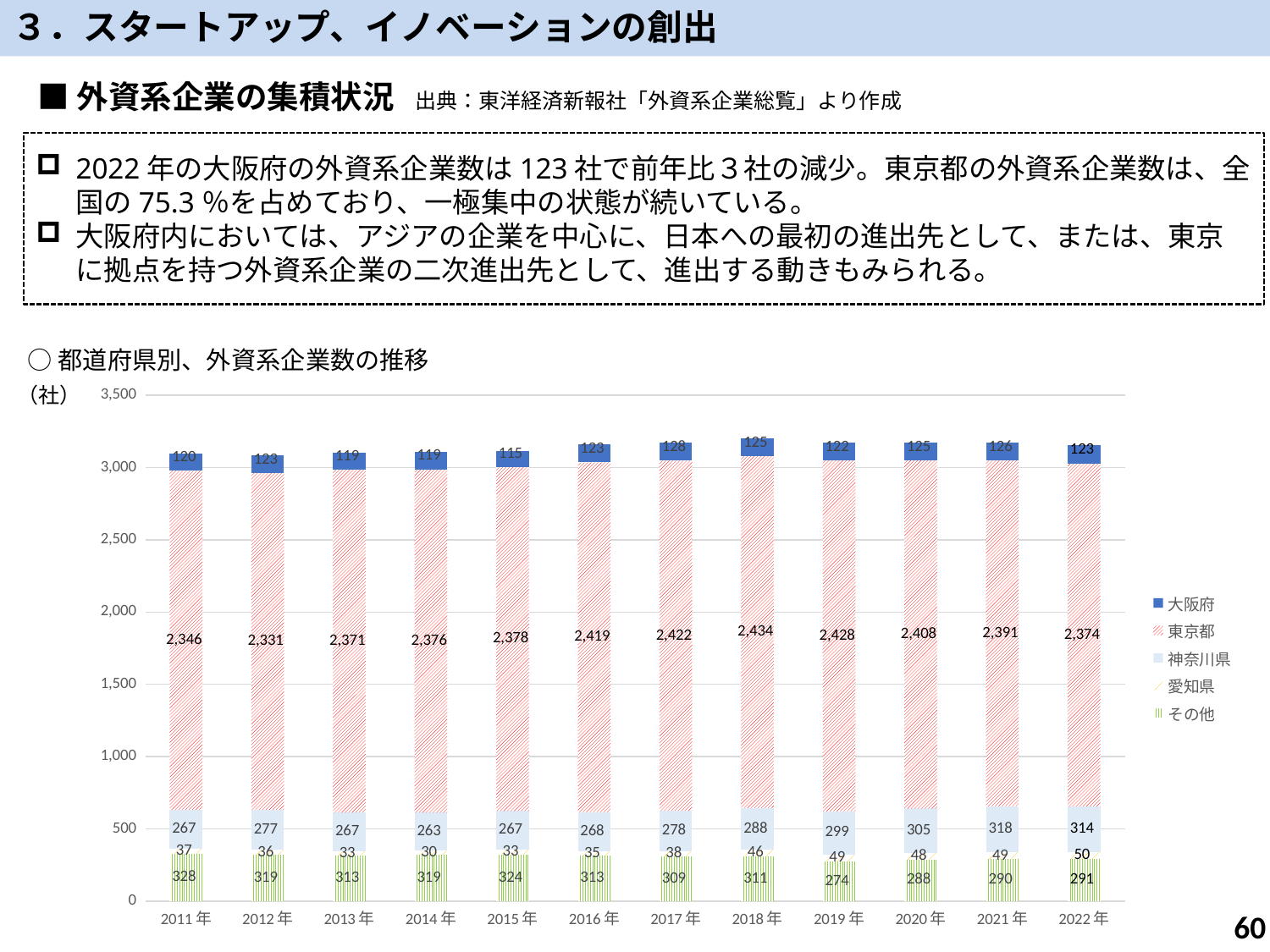
What kind of chart is shown? Stacked bar chart What is the total of the stacked bar for 2022年? 3,152 What is the value for 大阪府 in 2022年? 123 What is the value for その他 in 2011年? 328 What is the difference between the 大阪府 values for 2021年 and 2022年? 3 What is the value for 神奈川県 in 2021年? 318 In which year is the value for 東京都 the highest? 2018年 How many years are shown on the x axis? 12 In which year is the value for 東京都 the lowest? 2012年 Which is larger, the 神奈川県 value in 2011年 or in 2022年? 2022年 What is the value for 東京都 in 2018年? 2,434 How many series does the legend list? 5